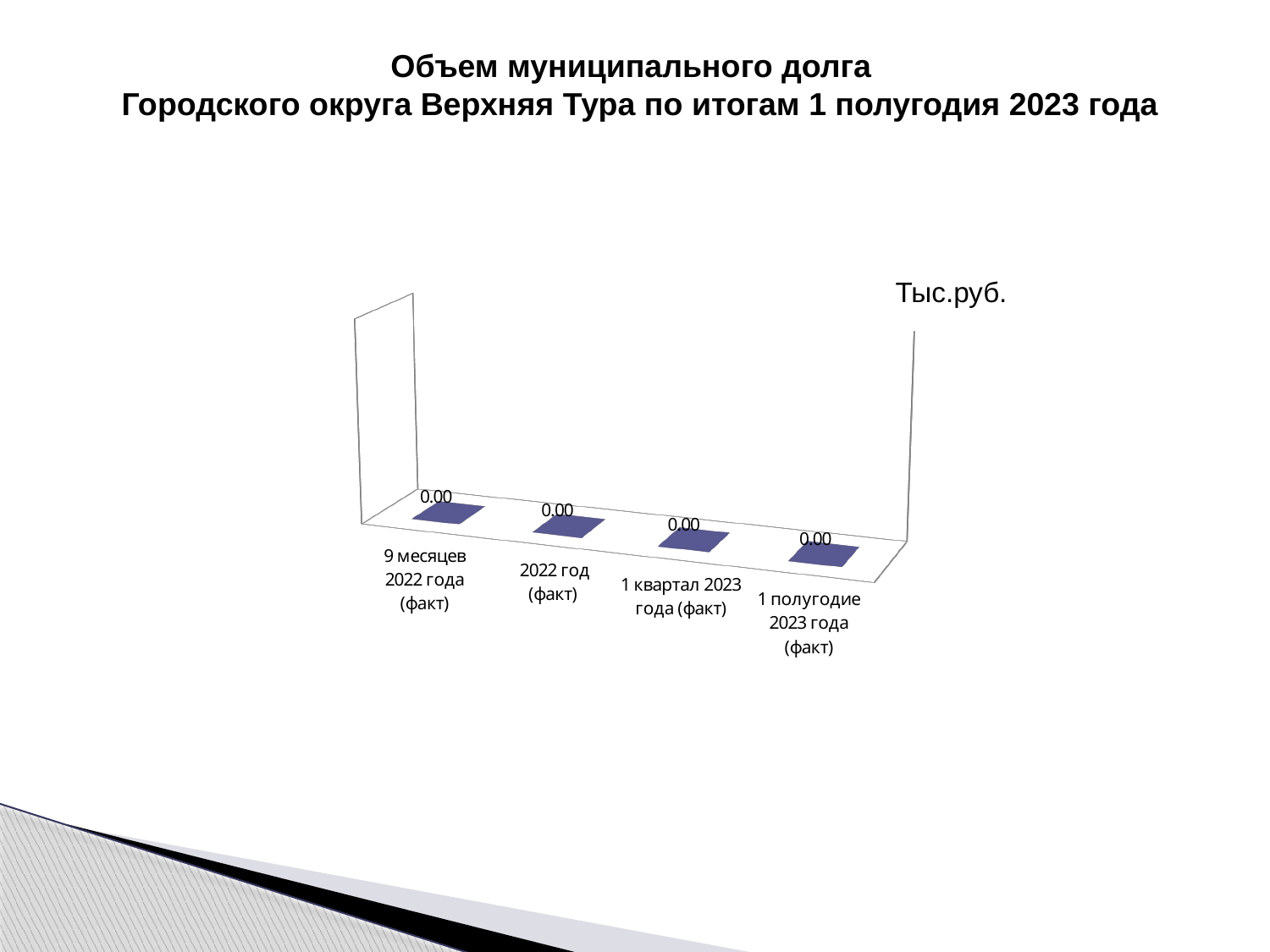
How many categories are shown on the x axis of the chart? 4 What kind of chart is shown on the slide? bar chart What is the value for 1 квартал 2023 года (факт)? 0.00 What unit of measurement is indicated next to the chart? Тыс.руб. What is the difference between the values for 9 месяцев 2022 года (факт) and 1 квартал 2023 года (факт)? 0.00 What is the title of the chart on the slide? Объем муниципального долга Городского округа Верхняя Тура по итогам 1 полугодия 2023 года What is the value for 2022 год (факт)? 0.00 What is the value for 1 полугодие 2023 года (факт)? 0.00 What is the value for 9 месяцев 2022 года (факт)? 0.00 Do the values rise, fall or stay the same from 9 месяцев 2022 года to 1 полугодие 2023 года? stay the same What is the difference between the values for 2022 год (факт) and 1 полугодие 2023 года (факт)? 0.00